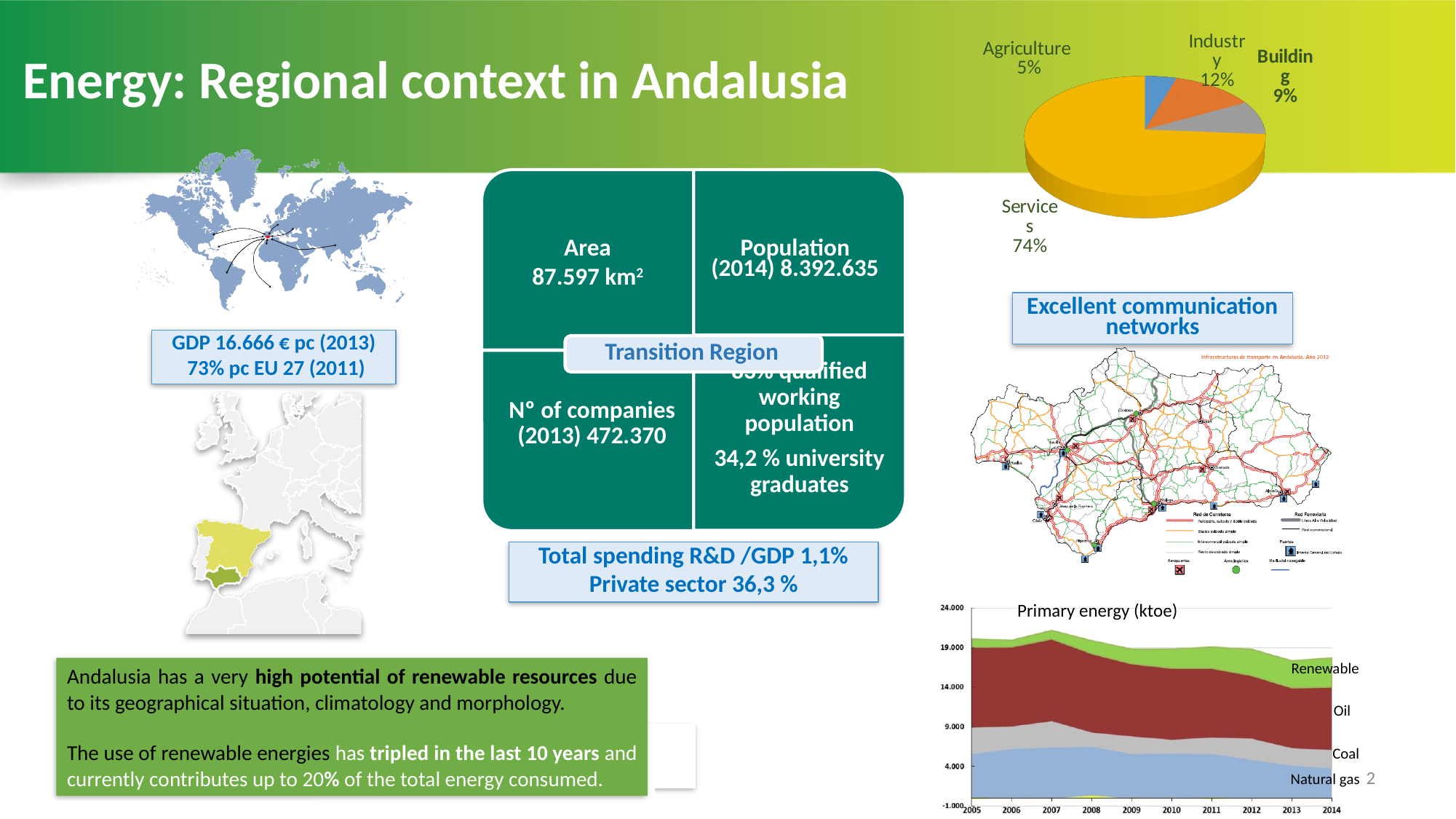
On the pie chart at the top right, which sector has the largest share? Services On the pie chart at the top right, what share does Services have? 74% On the pie chart at the top right, what share does Agriculture have? 5% What kind of chart is the 'Primary energy (ktoe)' chart at the bottom right? Stacked area chart How many years are shown on the x axis of the 'Primary energy (ktoe)' chart? 10 In the 'Primary energy (ktoe)' chart, does the total primary energy rise or fall from 2007 to 2014? Fall On the pie chart at the top right, which sector has the smallest share? Agriculture On the pie chart at the top right, what share does Industry have? 12% On the pie chart at the top right, what is the difference between the Industry share and the Building share? 3% How many slices does the pie chart at the top right have? 4 On the pie chart at the top right, which is larger, Industry or Building? Industry